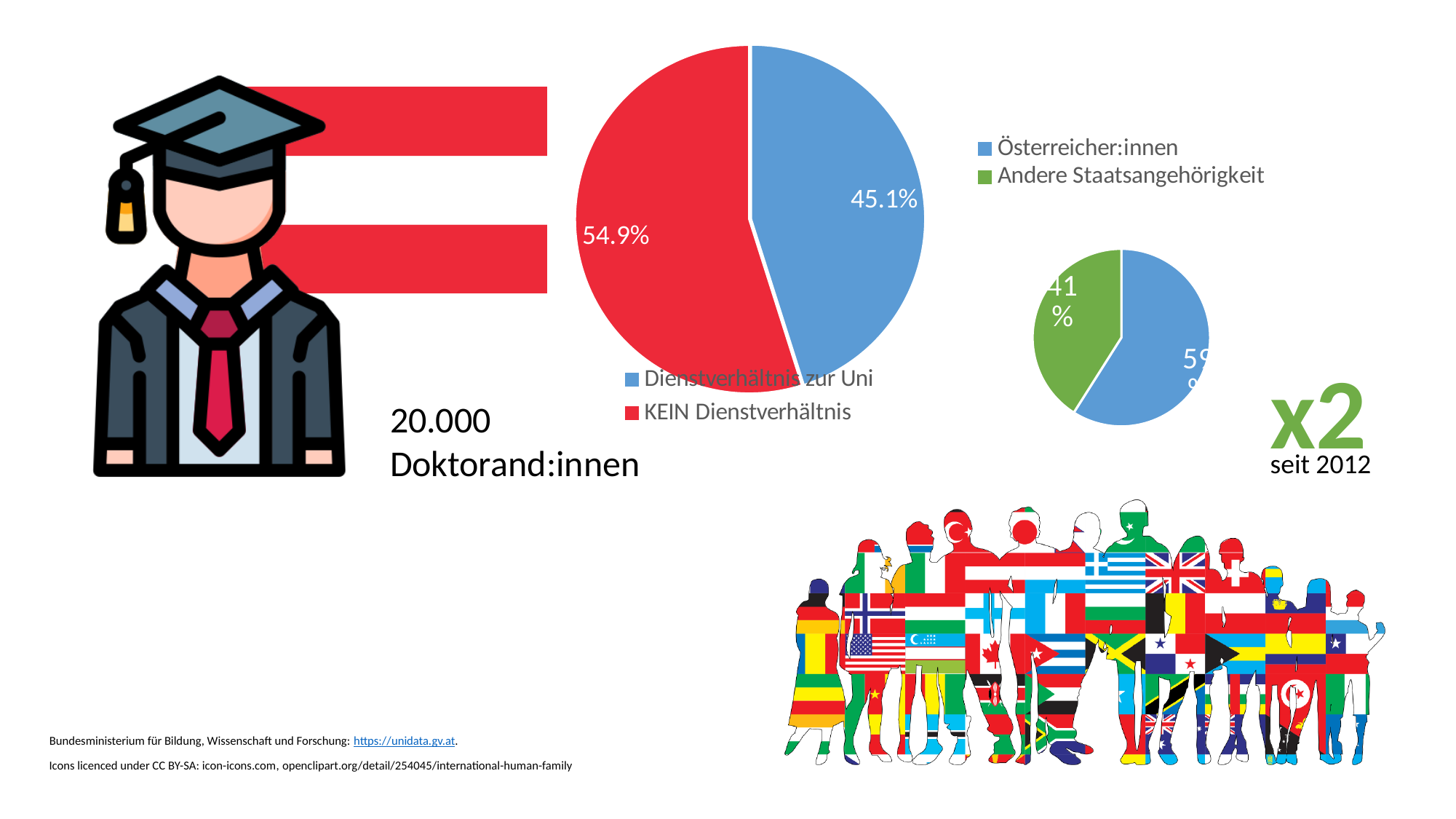
In the small pie chart on the right, what percentage is shown for Andere Staatsangehörigkeit? 41% What type of chart is the large chart on the left? pie chart In the large pie chart on the left, what is the difference in percentage points between KEIN Dienstverhältnis and Dienstverhältnis zur Uni? 9.8 In the large pie chart on the left, how many categories does the legend list? 2 In the large pie chart on the left, what percentage is shown for Dienstverhältnis zur Uni? 45.1% In the large pie chart on the left, which category has the smaller share? Dienstverhältnis zur Uni In the small pie chart on the right, how many categories does the legend list? 2 In the large pie chart on the left, which category has the larger share? KEIN Dienstverhältnis In the large pie chart on the left, which colour represents KEIN Dienstverhältnis? red In the large pie chart on the left, what percentage is shown for KEIN Dienstverhältnis? 54.9% In the small pie chart on the right, which category has the larger share, Österreicher:innen or Andere Staatsangehörigkeit? Österreicher:innen In the small pie chart on the right, which colour represents Andere Staatsangehörigkeit? green